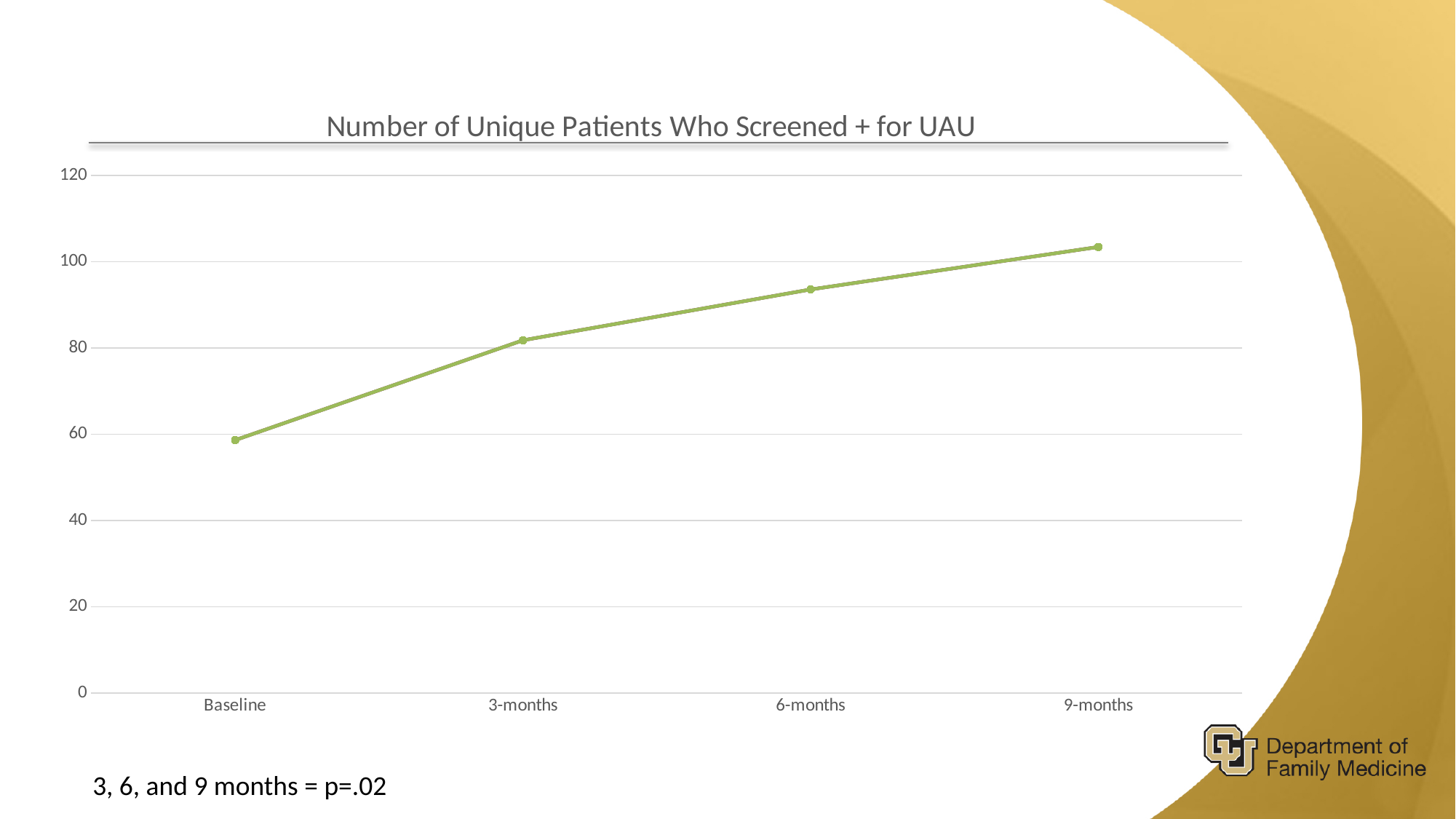
What kind of chart is shown on the slide? line chart Is the value at 3-months greater or less than 80? greater Which time point has the lowest number of unique patients who screened positive for UAU? Baseline Which time point has the highest number of unique patients who screened positive for UAU? 9-months Is the value at Baseline greater or less than 60? less Is the value at 9-months greater or less than 100? greater How many time points are plotted on the x axis? 4 Do the values rise or fall from Baseline to 9-months? rise What is the highest value labelled on the y axis? 120 What is the title of the chart? Number of Unique Patients Who Screened + for UAU Which is larger, the value at 3-months or the value at 6-months? 6-months